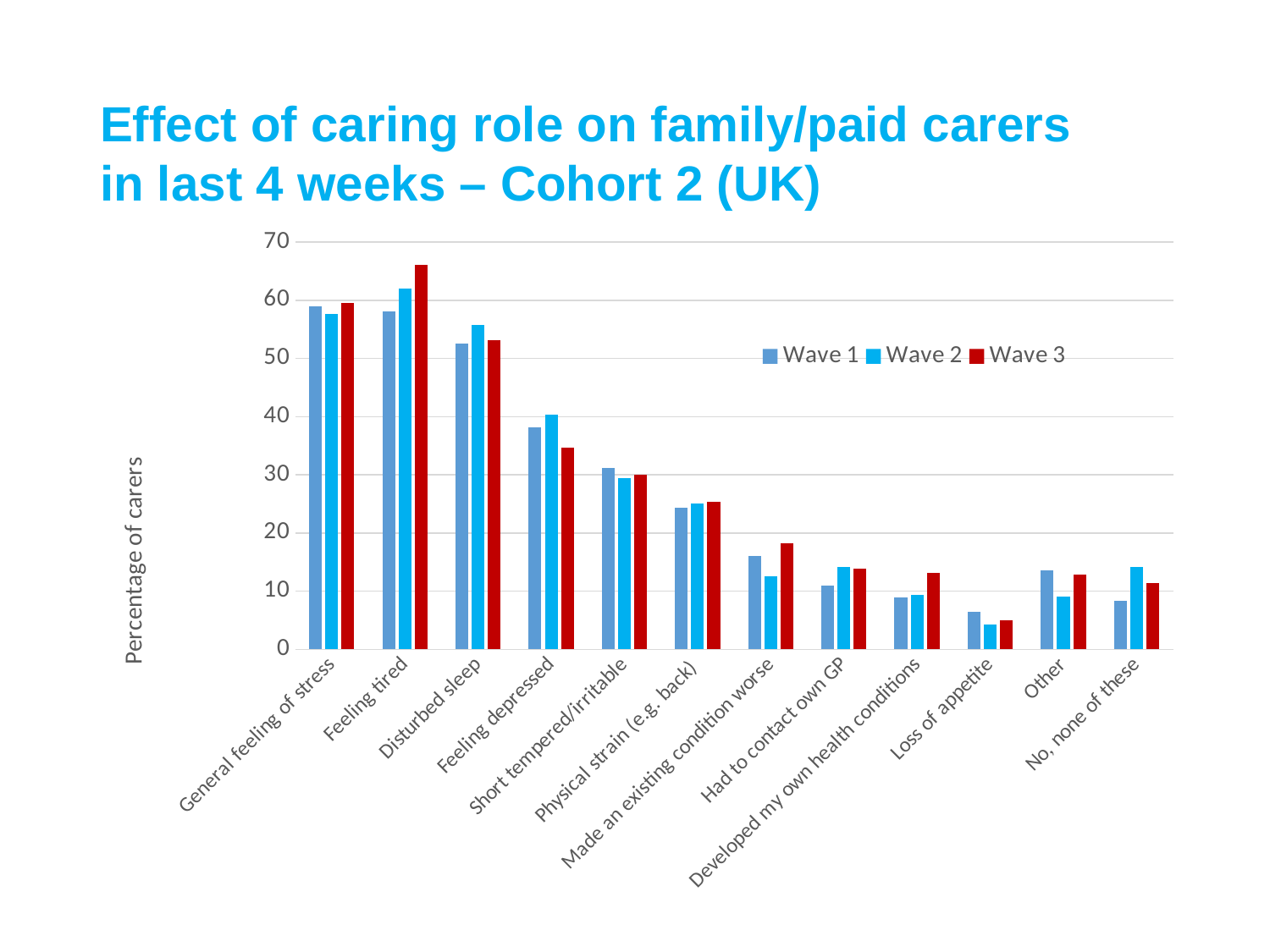
Is the Wave 3 value for Feeling tired greater or less than 60? greater How many series does the legend list? 3 What kind of chart is shown on the slide? Bar chart For Feeling tired, which is larger: the Wave 2 value or the Wave 3 value? Wave 3 Which category has the highest Wave 3 value? Feeling tired Is the Wave 1 value for Loss of appetite greater or less than 10? less For Made an existing condition worse, which is larger: the Wave 1 value or the Wave 2 value? Wave 1 What is the label on the vertical axis? Percentage of carers How many categories are shown along the x axis? 12 Is the Wave 3 value for Feeling depressed greater or less than 40? less Which category has the lowest Wave 2 value? Loss of appetite